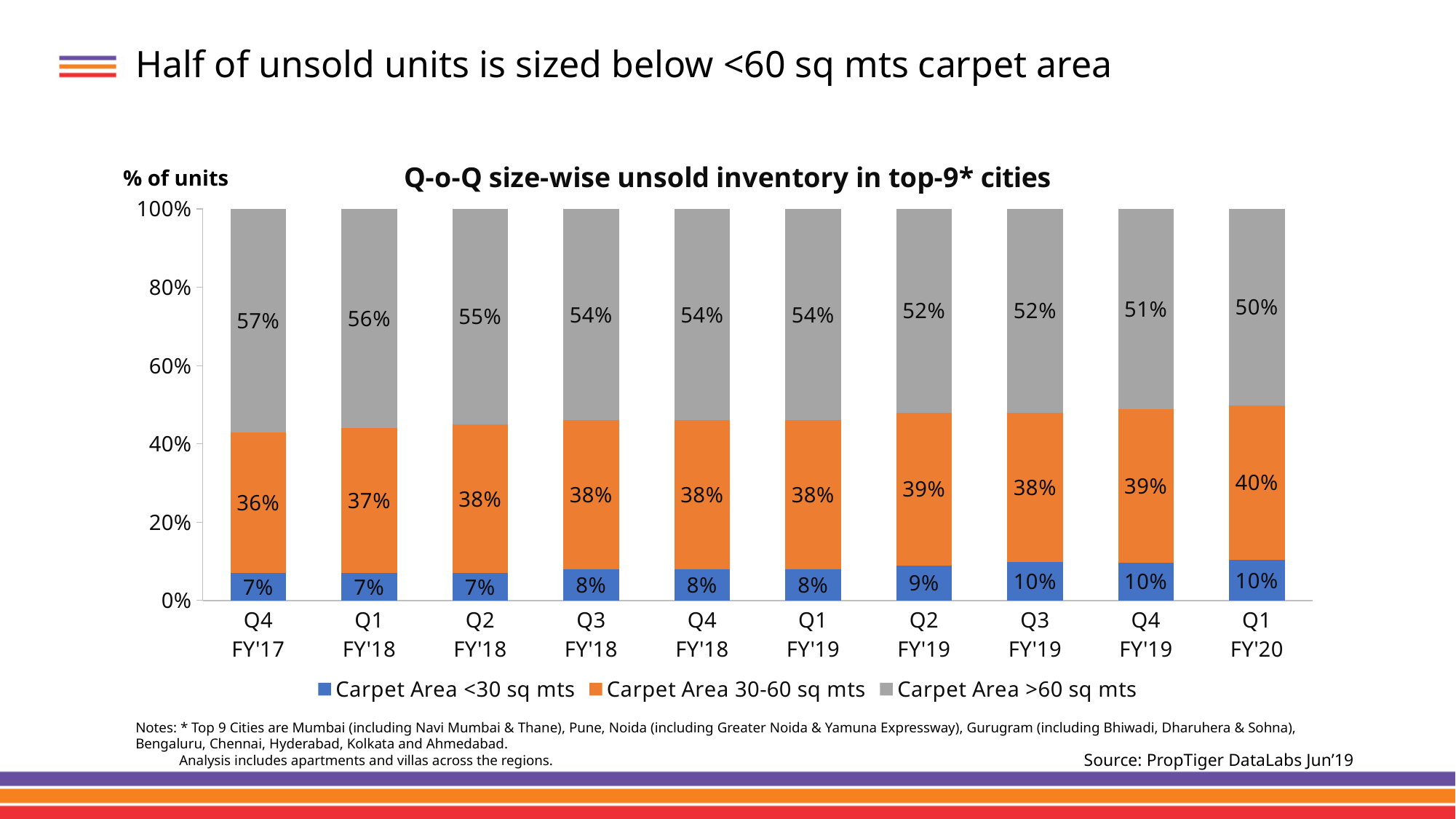
What is the value for Carpet Area <30 sq mts in Q2 FY'19? 9% How many quarters are shown on the x axis? 10 What is the difference between the Carpet Area >60 sq mts share in Q4 FY'17 and in Q1 FY'20? 7% Which is larger in Q1 FY'18: the Carpet Area 30-60 sq mts share or the Carpet Area >60 sq mts share? Carpet Area >60 sq mts What is the value for Carpet Area >60 sq mts in Q4 FY'17? 57% What kind of chart is shown on the slide? Stacked bar chart In which quarter is the Carpet Area >60 sq mts share the lowest? Q1 FY'20 In which quarter is the Carpet Area >60 sq mts share the highest? Q4 FY'17 Does the Carpet Area >60 sq mts share rise or fall from Q4 FY'17 to Q1 FY'20? Fall What is the title of the chart? Q-o-Q size-wise unsold inventory in top-9* cities How many series does the legend list? 3 What is the value for Carpet Area 30-60 sq mts in Q1 FY'20? 40%